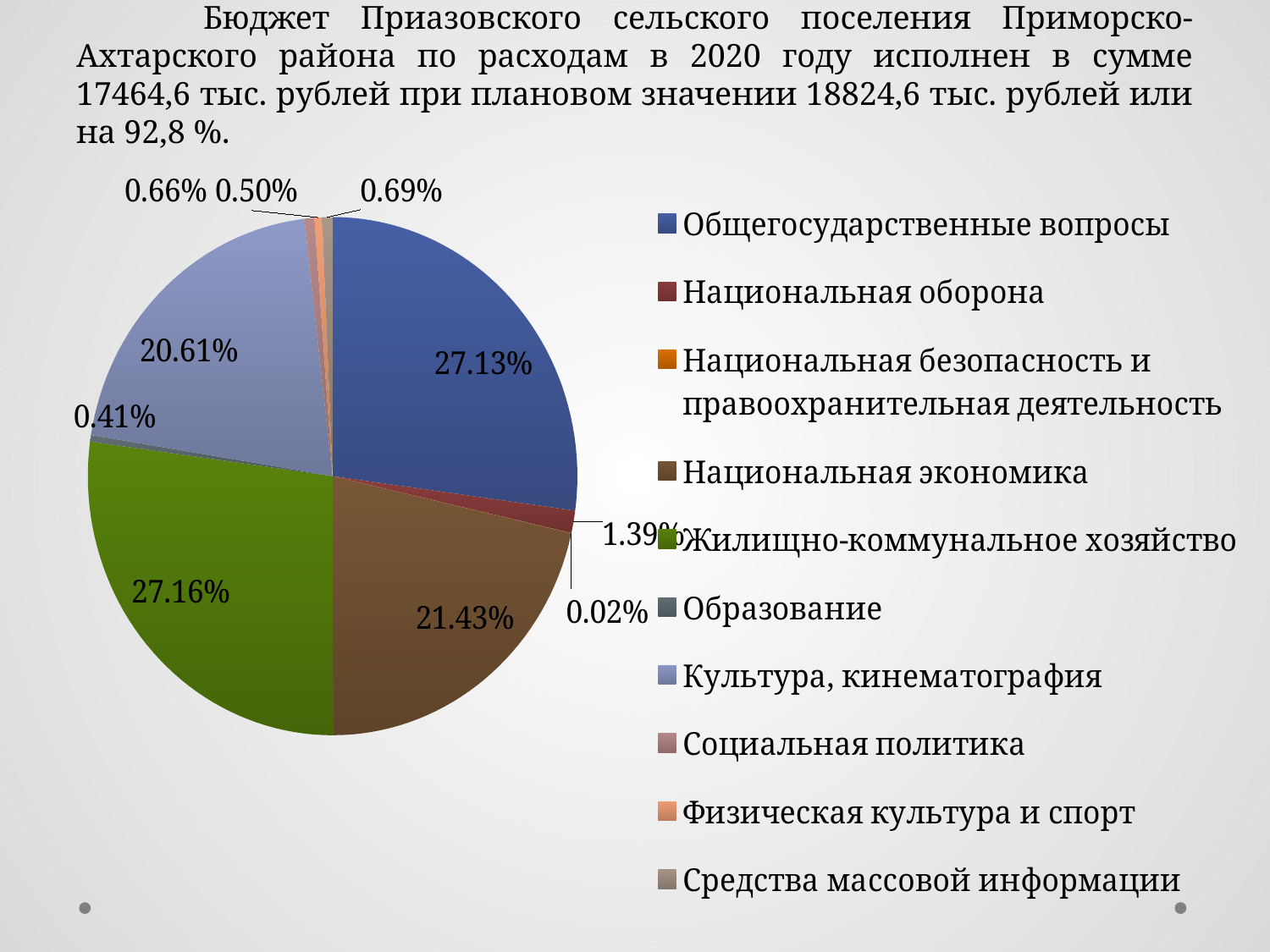
Which category has the smallest slice of the pie? Национальная безопасность и правоохранительная деятельность What is the difference in percentage points between the "Жилищно-коммунальное хозяйство" slice and the "Национальная экономика" slice? 5.73% What share of the pie does "Национальная оборона" have? 1.39% How many categories does the legend of the pie chart list? 10 What colour is the slice for "Жилищно-коммунальное хозяйство"? Green What share of the pie does "Культура, кинематография" have? 20.61% What share of the pie does "Национальная экономика" have? 21.43% What type of chart is shown on the slide? Pie chart Which category has the largest slice of the pie? Жилищно-коммунальное хозяйство Which is larger: the slice for "Национальная экономика" or the slice for "Культура, кинематография"? Национальная экономика